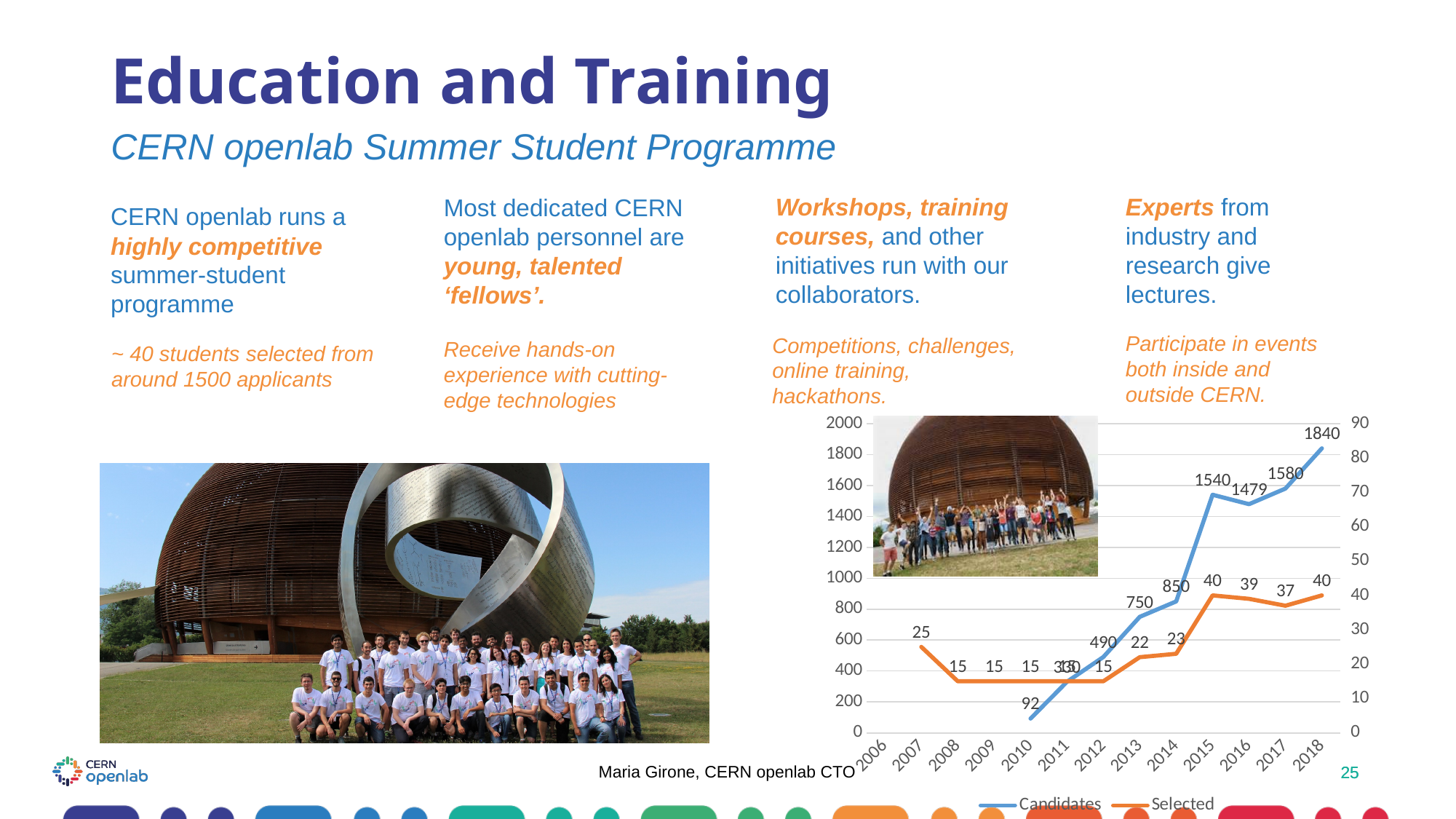
In which year is the number of Candidates highest? 2018 What is the number of Candidates in 2014? 850 What are the two series named in the chart legend? Candidates and Selected In which year is the number of Candidates lowest? 2010 How many series does the chart legend list? 2 What is the number of Candidates in 2018? 1840 Which year had more Candidates, 2015 or 2016? 2015 What is the number of Selected students in 2007? 25 Do the Candidates values generally rise or fall from 2010 to 2018? Rise What is the difference between the number of Candidates in 2018 and in 2017? 260 What is the number of Selected students in 2015? 40 What kind of chart is shown on the slide? Line chart